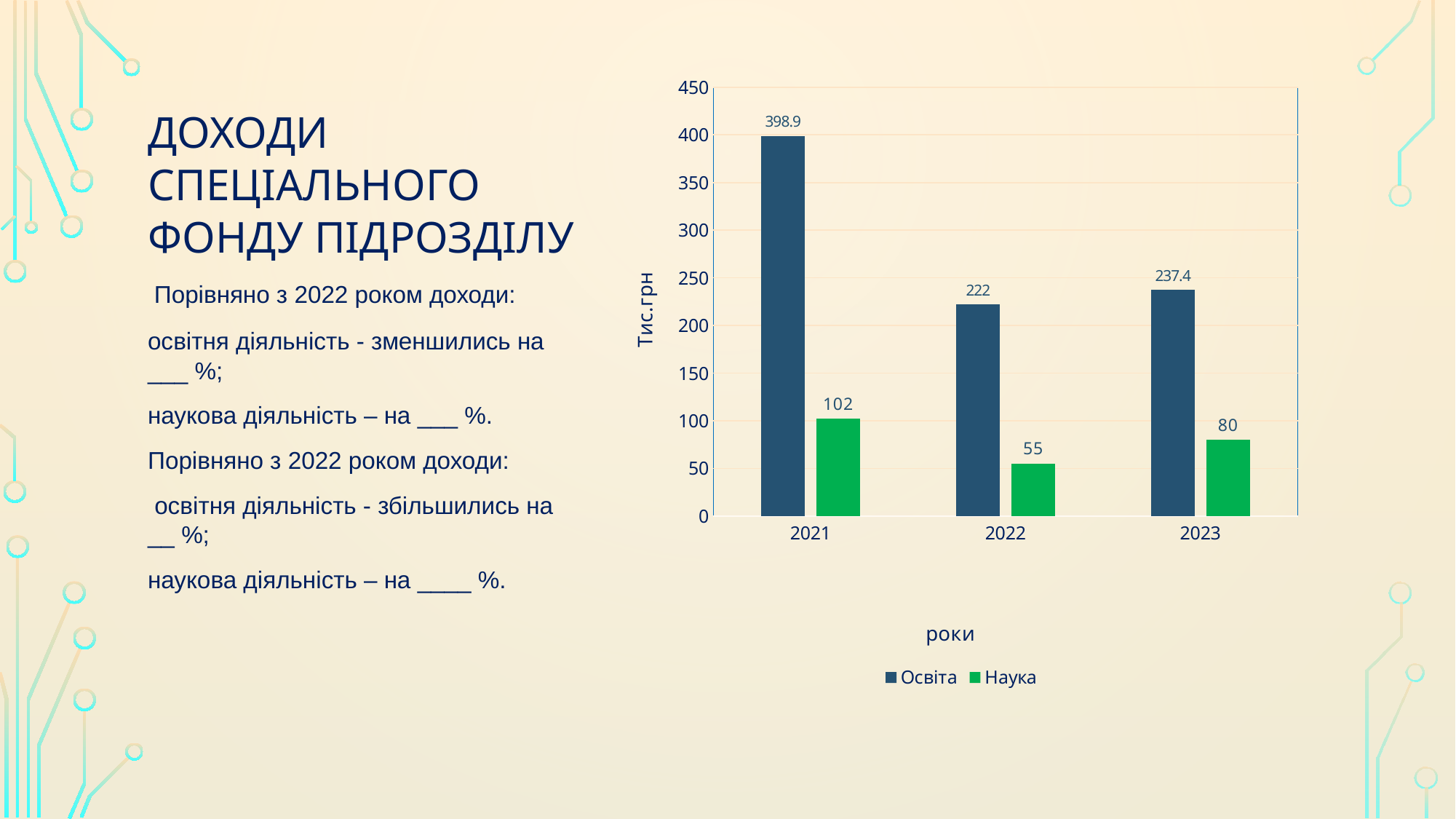
What is the value for Освіта in 2021? 398.9 What is the value for Наука in 2022? 55 What is the value for Освіта in 2023? 237.4 Which is larger: Наука in 2021 or Наука in 2023? Наука in 2021 In which year is the Наука value lowest? 2022 What kind of chart is shown on the slide? Bar chart In which year is the Освіта value highest? 2021 What is the label of the vertical axis? Тис.грн What is the difference between the Освіта values for 2021 and 2022? 176.9 What is the value for Наука in 2023? 80 How many years are shown on the x axis? 3 How many series does the legend list? 2